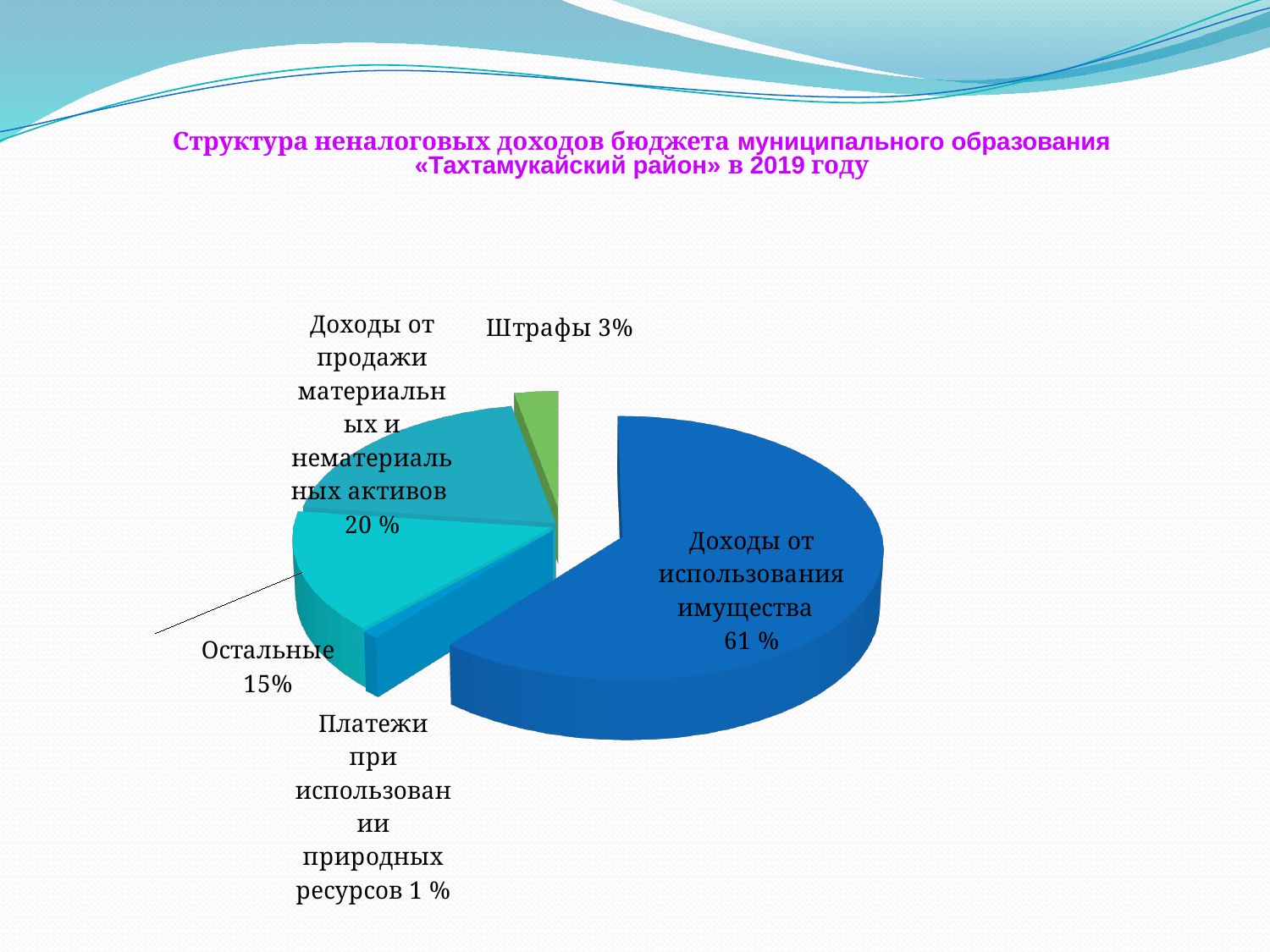
What value is shown for «Остальные»? 15% Which is larger: «Остальные» or «Штрафы»? Остальные What share of the pie does «Доходы от использования имущества» have? 61 % What value is shown for «Платежи при использовании природных ресурсов»? 1 % What is the title of the slide? Структура неналоговых доходов бюджета муниципального образования «Тахтамукайский район» в 2019 году Which category has the largest slice of the pie? Доходы от использования имущества What is the difference in percentage points between «Доходы от использования имущества» and «Доходы от продажи материальных и нематериальных активов»? 41 How many slices does the pie chart have? 5 Which category has the smallest slice of the pie? Платежи при использовании природных ресурсов What kind of chart is shown on the slide? Pie chart What value is shown for «Штрафы»? 3% What value is shown for «Доходы от продажи материальных и нематериальных активов»? 20 %